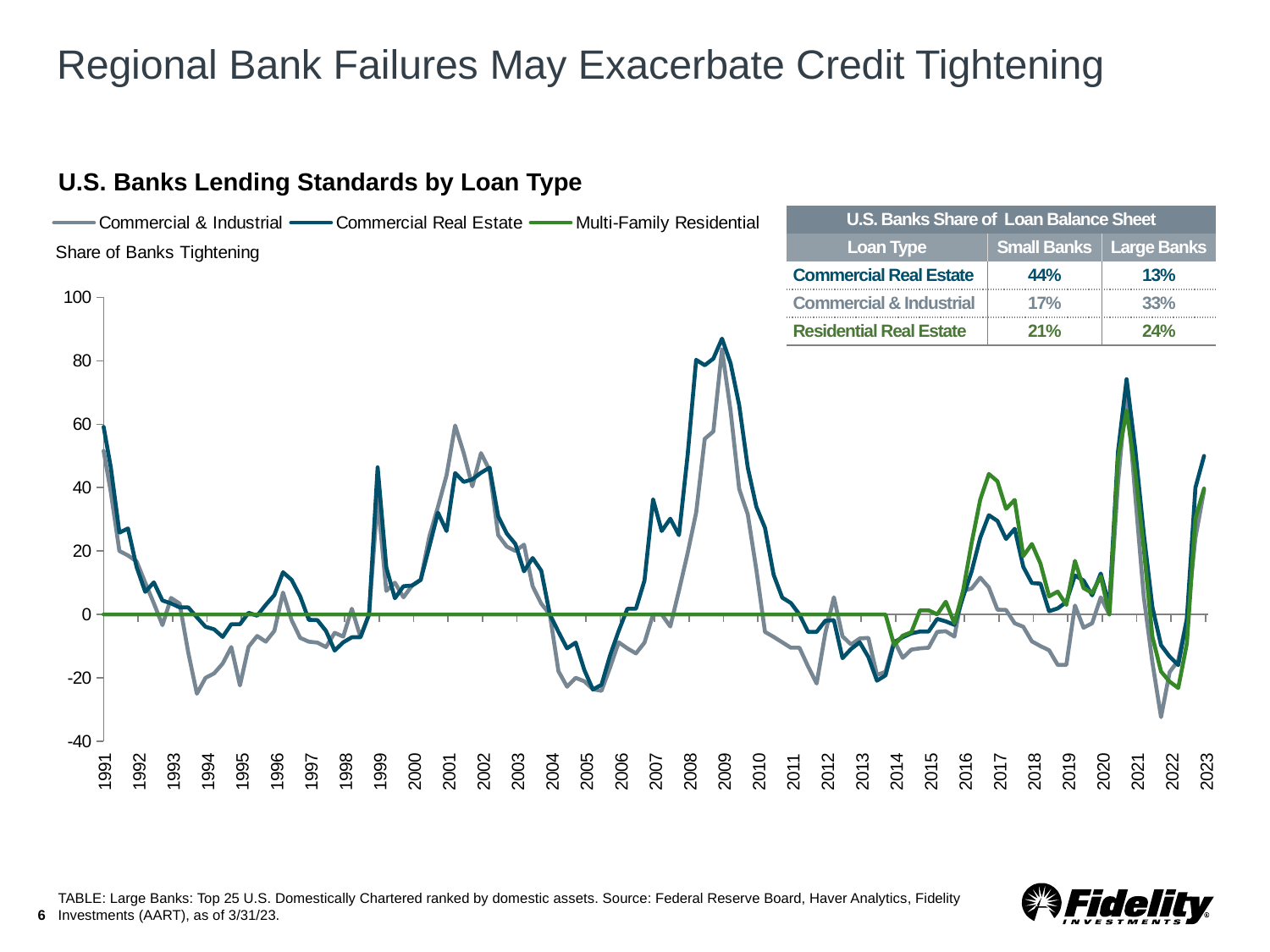
In the 'U.S. Banks Lending Standards by Loan Type' chart, which series reaches the lowest value anywhere on the chart? Commercial & Industrial In the 'U.S. Banks Lending Standards by Loan Type' chart, is the lowest value of Commercial & Industrial around 2021 greater or less than -20? less What kind of chart is shown under the heading 'U.S. Banks Lending Standards by Loan Type'? Line chart How many series does the legend of the 'U.S. Banks Lending Standards by Loan Type' chart list? 3 In the 'U.S. Banks Lending Standards by Loan Type' chart, is the peak value of Multi-Family Residential around 2016-2017 greater or less than 20? greater What is the label shown above the y axis of the 'U.S. Banks Lending Standards by Loan Type' chart? Share of Banks Tightening In the 'U.S. Banks Lending Standards by Loan Type' chart, which series peaks higher around 2016-2017: Multi-Family Residential or Commercial Real Estate? Multi-Family Residential In the 'U.S. Banks Lending Standards by Loan Type' chart, is the value of Commercial Real Estate at 2023 greater or less than 40? greater In the 'U.S. Banks Lending Standards by Loan Type' chart, do the values for all three series rise or fall from 2022 to 2023? rise How many year labels are shown on the x axis of the 'U.S. Banks Lending Standards by Loan Type' chart? 33 Which series in the 'U.S. Banks Lending Standards by Loan Type' chart is drawn in green? Multi-Family Residential